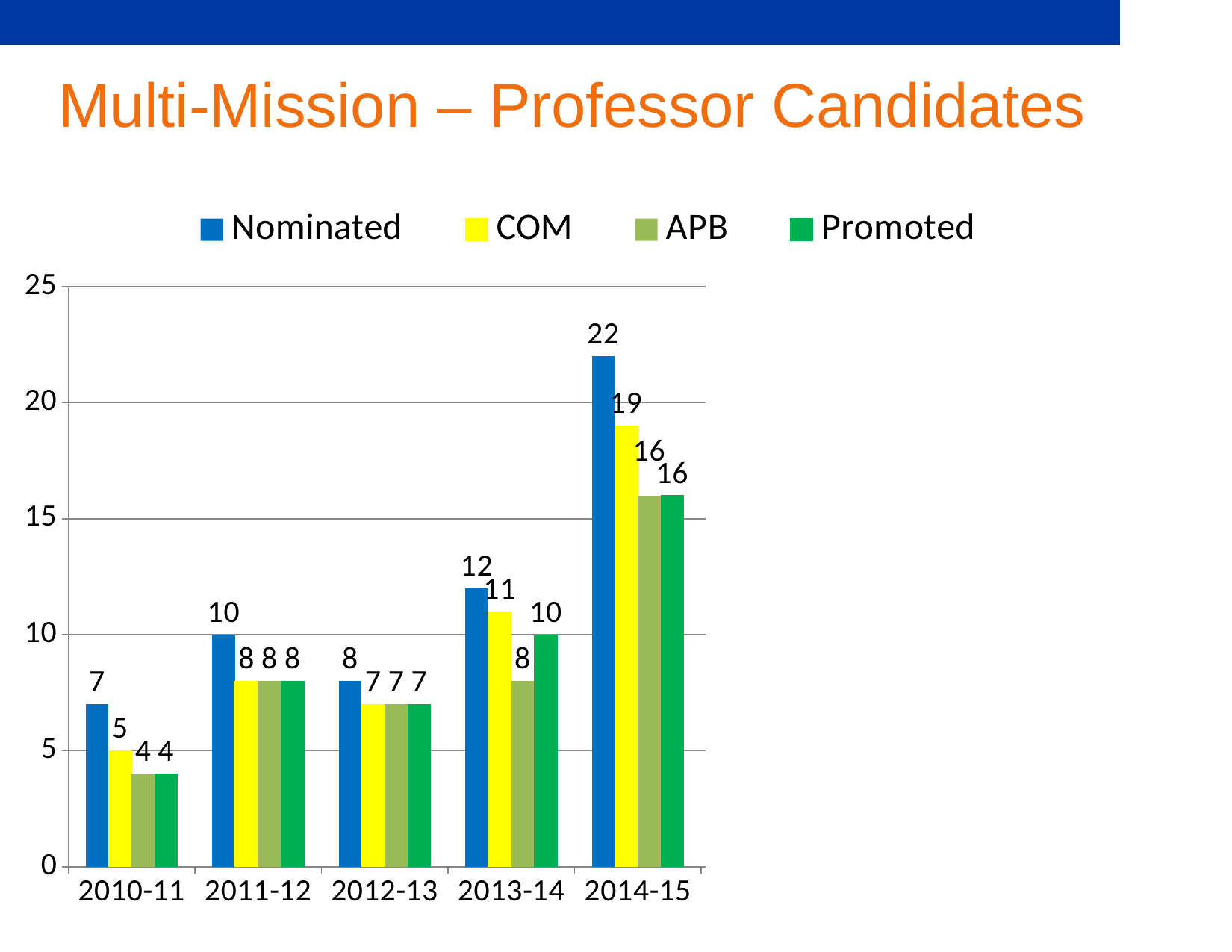
What is the difference between Nominated and Promoted in 2014-15? 6 What is the COM value for 2013-14? 11 Which year has the highest Nominated value? 2014-15 How many Nominated candidates were there in 2014-15? 22 What is the Promoted value for 2010-11? 4 Which is larger in 2013-14, the COM value or the APB value? COM How many series does the legend list? 4 What is the title of the slide? Multi-Mission – Professor Candidates What kind of chart is shown on the slide? Bar chart Does the Nominated value rise or fall from 2012-13 to 2014-15? Rise Which year has the lowest Promoted value? 2010-11 How many years are shown on the x axis? 5